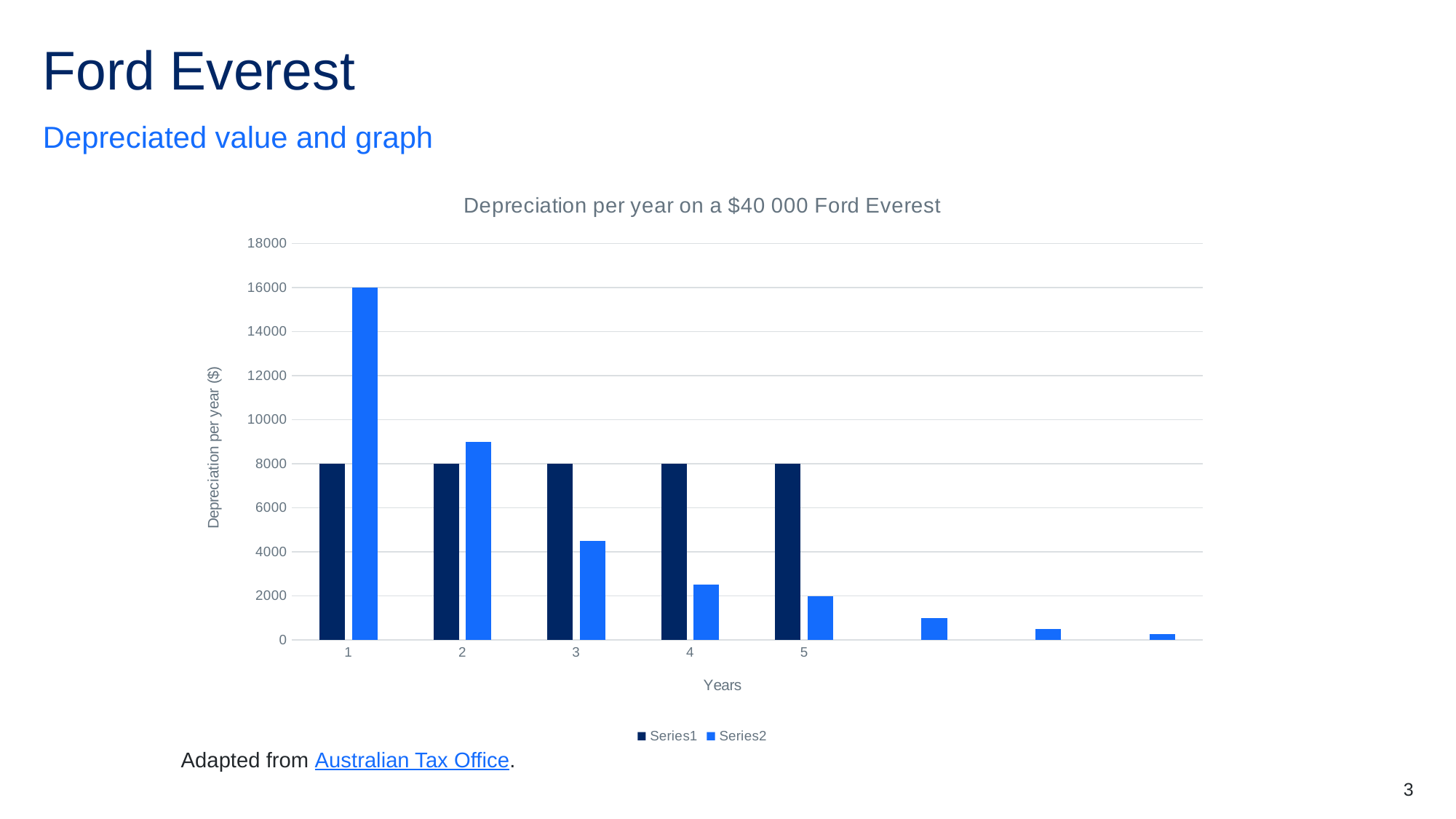
What kind of chart is shown on the slide? bar chart Which year has the highest Series2 value? 1 What is the Series1 value for year 1? 8000 Is the Series2 value for year 3 greater or less than 6000? less In year 2, which series has the larger value, Series1 or Series2? Series2 How many series does the legend list? 2 What is the Series2 value for year 1? 16000 What is the title of the chart? Depreciation per year on a $40 000 Ford Everest In year 3, which series has the larger value, Series1 or Series2? Series1 What is the difference between the Series2 and Series1 values in year 1? 8000 Is the Series2 value for year 2 greater or less than 8000? greater Do the Series2 values rise or fall as the years increase? fall